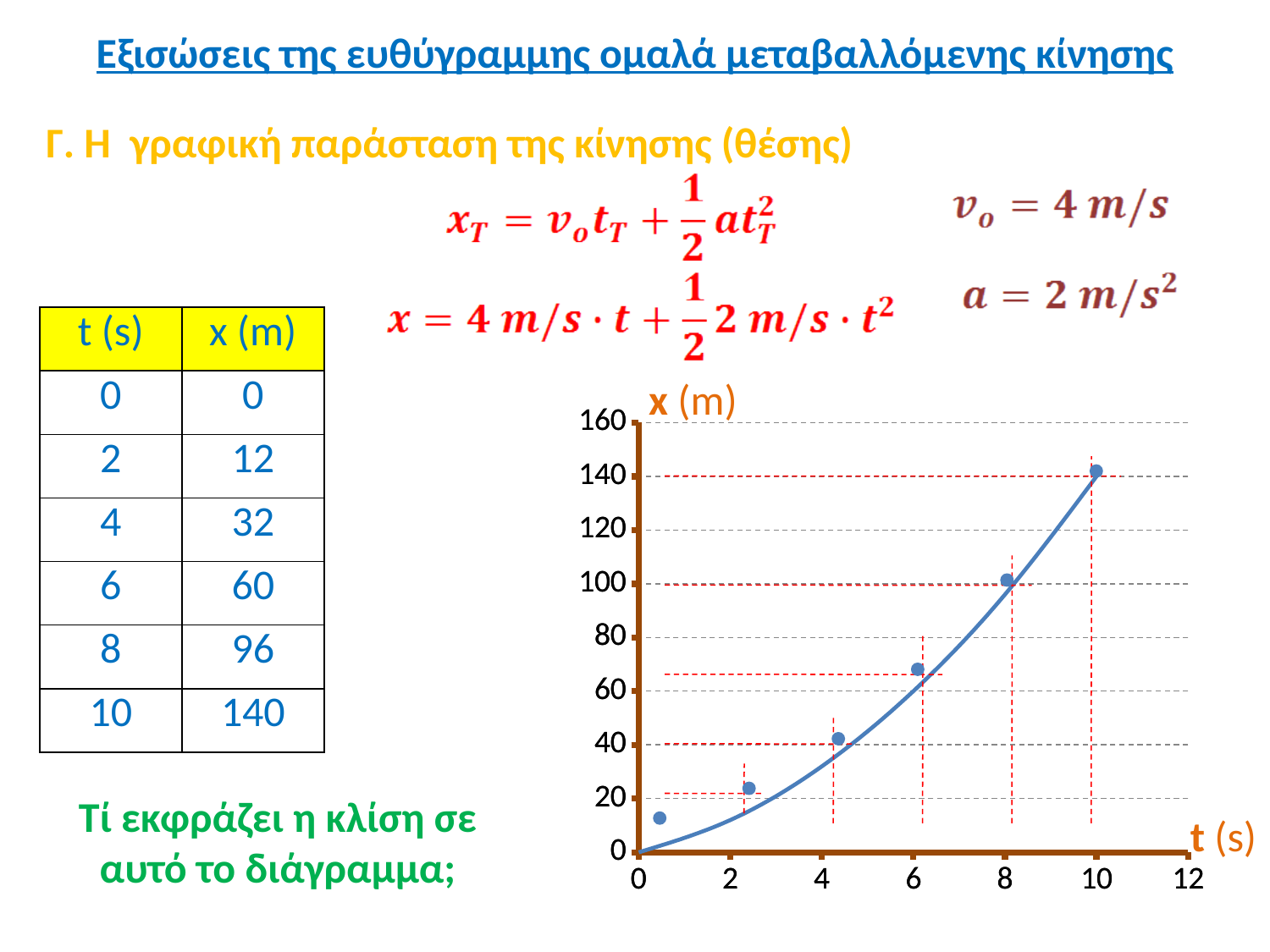
Is the plotted value of x at t = 6 s greater or less than 80? less Is the plotted value of x at t = 8 s greater or less than 140? less What is the value of x (m) at t = 0 s? 0 At which value of t is the plotted position x highest? 10 Is the plotted value of x at t = 4 s greater or less than 60? less What kind of chart is shown on the slide? line chart What is the value of x (m) at t = 10 s? 140 What is the label of the vertical axis of the chart? x (m) Do the plotted x values rise or fall as t increases along the x axis? rise At which value of t is the plotted position x lowest? 0 Which is larger, the plotted x value at t = 8 s or at t = 4 s? t = 8 s How many data points are plotted on the chart? 6